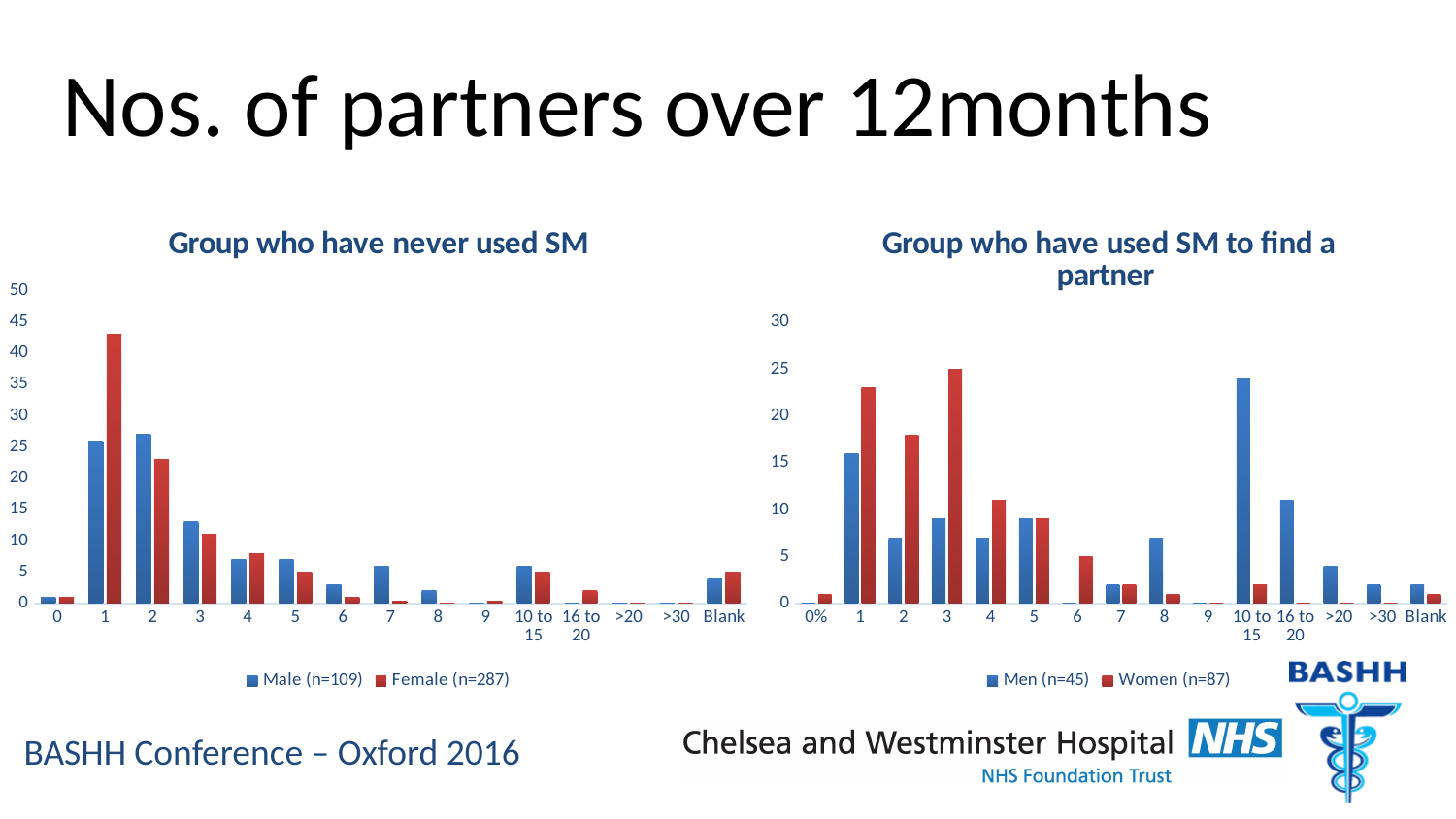
What are the two legend entries on the 'Group who have never used SM' chart? Male (n=109) and Female (n=287) In the 'Group who have used SM to find a partner' chart, which category has the highest Women (n=87) value? 3 In the 'Group who have never used SM' chart, which is larger for category 1, the Male (n=109) value or the Female (n=287) value? Female (n=287) In the 'Group who have never used SM' chart, is the Male (n=109) value for category 3 greater or less than 10? greater How many categories are shown on the x axis of the 'Group who have never used SM' chart? 15 In the 'Group who have used SM to find a partner' chart, is the Men (n=45) value for '10 to 15' greater or less than 20? greater In the 'Group who have never used SM' chart, is the Female (n=287) value for category 1 greater or less than 40? greater In the 'Group who have never used SM' chart, which category has the highest Female (n=287) value? 1 How many series does the legend of the 'Group who have used SM to find a partner' chart list? 2 In the 'Group who have used SM to find a partner' chart, which category has the highest Men (n=45) value? 10 to 15 In the 'Group who have used SM to find a partner' chart, which is larger for category 3, the Men (n=45) value or the Women (n=87) value? Women (n=87) What type of chart is the 'Group who have never used SM' chart? bar chart